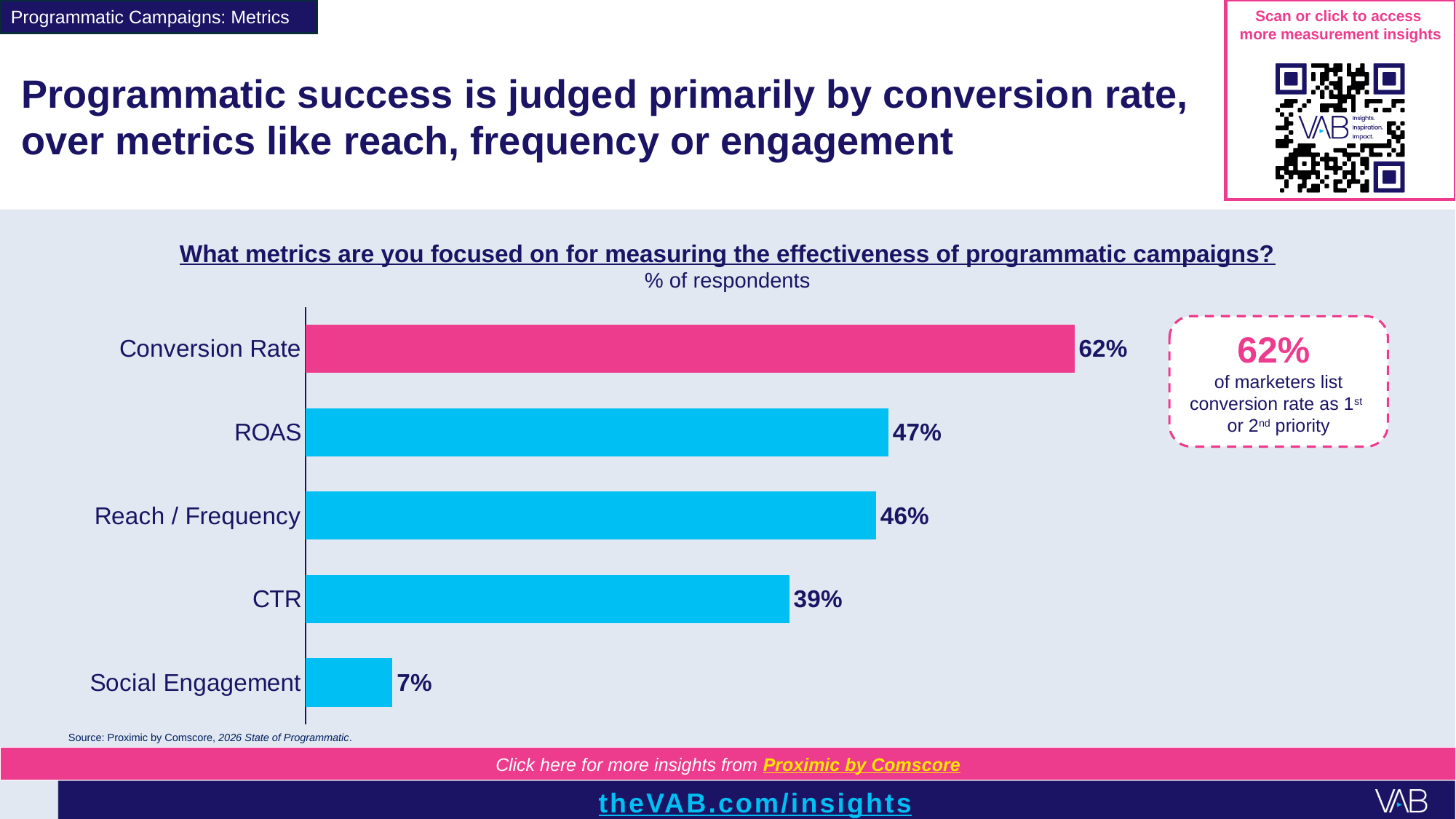
What is the difference in percentage points between Conversion Rate and ROAS? 15 What is the value shown for ROAS? 47% What percentage of respondents are focused on Social Engagement? 7% Which metric has the lowest percentage of respondents? Social Engagement What is the difference in percentage points between CTR and Social Engagement? 32 What percentage of respondents cite Reach / Frequency? 46% How many metrics are shown in the chart? 5 Which has a larger value, CTR or Reach / Frequency? Reach / Frequency What type of chart is used on the slide? Bar chart Which metric has the highest percentage of respondents? Conversion Rate What is the value for CTR? 39% What percentage of respondents are focused on Conversion Rate? 62%